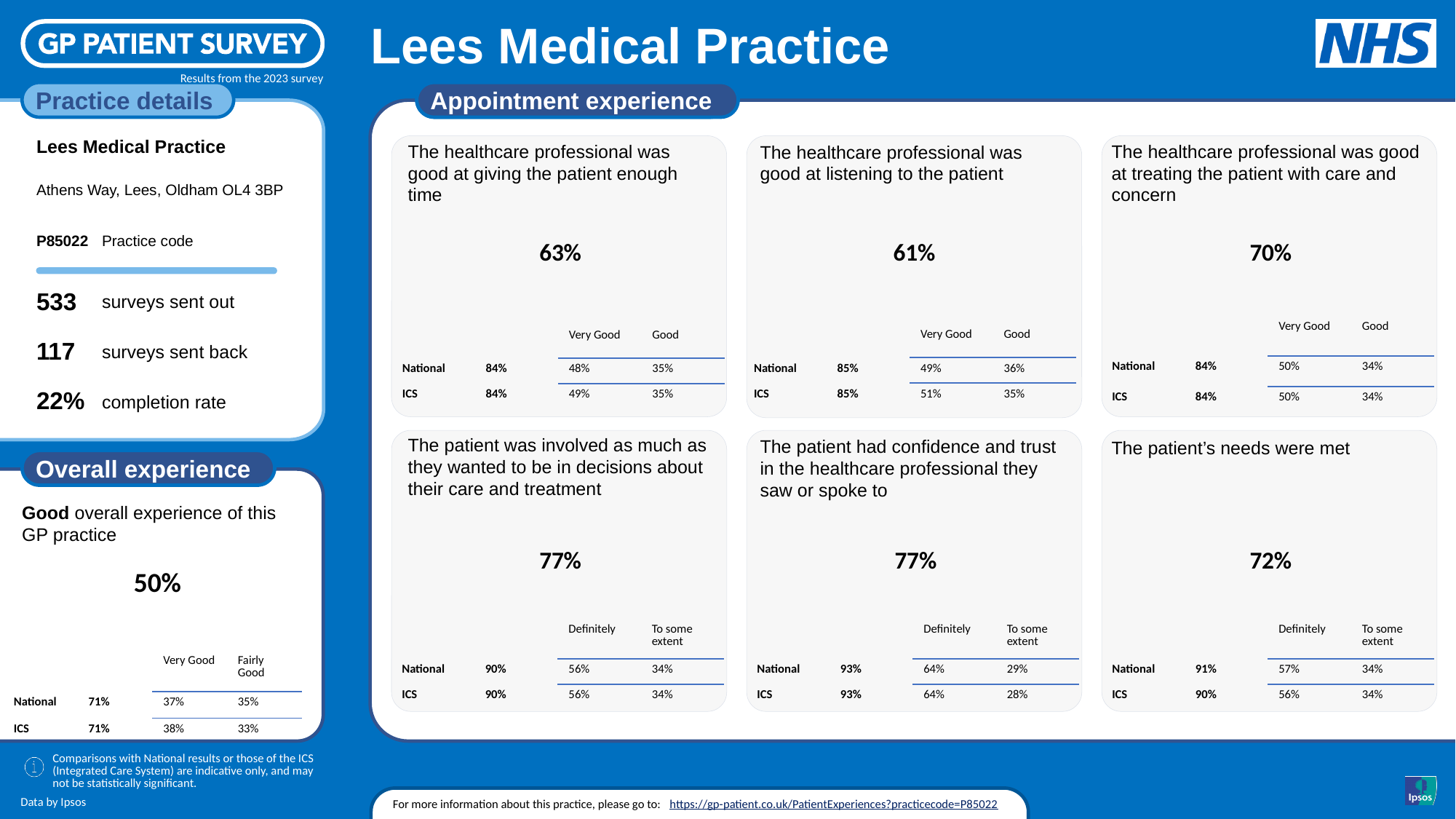
How many question panels are shown under the 'Appointment experience' heading? 6 On the 'Overall experience' panel, what percentage of patients reported a good overall experience of this GP practice? 50% On the panel 'The patient was involved as much as they wanted to be in decisions about their care and treatment', what is the difference between the National figure (90%) and the practice figure (77%)? 13 percentage points On the 'Overall experience' panel, what is the difference between the National figure (71%) and the practice figure (50%)? 21 percentage points On the panel 'The healthcare professional was good at listening to the patient', what is the ICS 'Very Good' percentage? 51% On the panel 'The patient had confidence and trust in the healthcare professional they saw or spoke to', what is the National figure? 93% On the panel 'The healthcare professional was good at giving the patient enough time', what is the practice's percentage? 63% On the panel 'The healthcare professional was good at treating the patient with care and concern', what is the practice's percentage? 70% On the panel 'The patient's needs were met', which is larger: the National figure or the ICS figure? National On the 'Overall experience' panel, what is the National figure for good overall experience? 71% Among the six 'Appointment experience' panels, which question has the lowest practice percentage? The healthcare professional was good at listening to the patient On the 'Overall experience' panel, what is the ICS 'Very Good' percentage? 38%